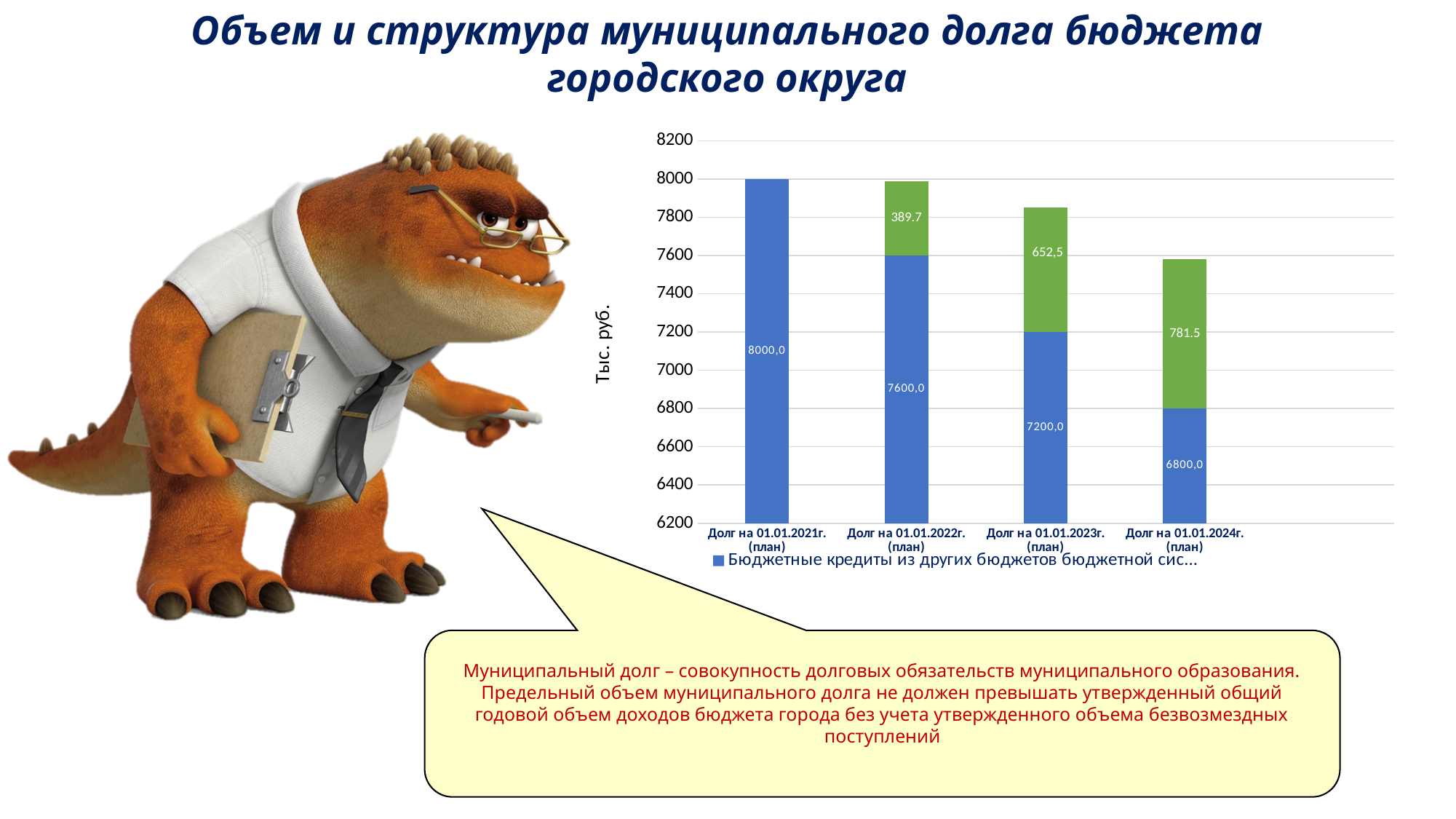
By how much does the blue value for "Долг на 01.01.2021г. (план)" exceed the blue value for "Долг на 01.01.2024г. (план)"? 1200,0 How many categories are shown on the x axis of the chart? 4 What is the value of the green segment for "Долг на 01.01.2022г. (план)"? 389.7 What is the value of the blue segment for "Долг на 01.01.2021г. (план)"? 8000,0 What is the value of the green segment for "Долг на 01.01.2023г. (план)"? 652,5 Do the blue series values rise or fall from left to right along the x axis? Fall Which category has the lowest value for the blue series? Долг на 01.01.2024г. (план) Which has the larger green segment: "Долг на 01.01.2023г. (план)" or "Долг на 01.01.2024г. (план)"? Долг на 01.01.2024г. (план) What is the value of the blue segment for "Долг на 01.01.2024г. (план)"? 6800,0 What kind of chart is shown on the slide? Stacked bar chart Which category has the highest value for the blue series? Долг на 01.01.2021г. (план) What is the value of the green segment for "Долг на 01.01.2024г. (план)"? 781.5